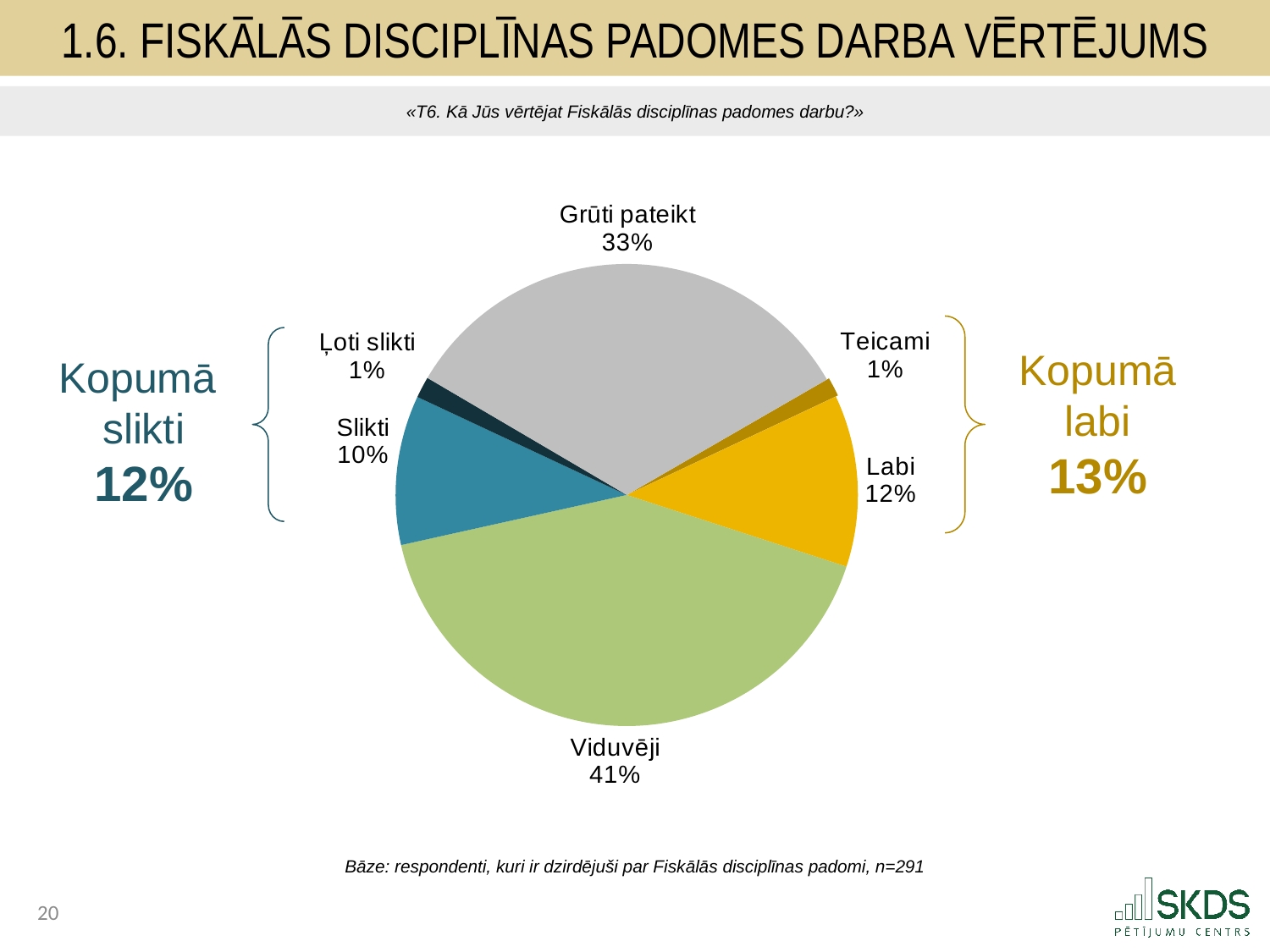
What type of chart is shown on the slide? pie chart What is the base (n) of respondents stated below the chart? n=291 Which category has the largest share of the pie? Viduvēji What is the combined share for "Slikti" and "Ļoti slikti" ("Kopumā slikti")? 12% Which is larger, the share for "Labi" or the share for "Slikti"? Labi What is the combined share for "Labi" and "Teicami" ("Kopumā labi")? 13% What is the difference between the "Viduvēji" share and the "Grūti pateikt" share? 8 percentage points How many slices does the pie chart have? 6 What percentage of respondents answered "Labi"? 12% What percentage of respondents answered "Slikti"? 10% What percentage of respondents answered "Grūti pateikt"? 33% What percentage of respondents answered "Viduvēji"? 41%